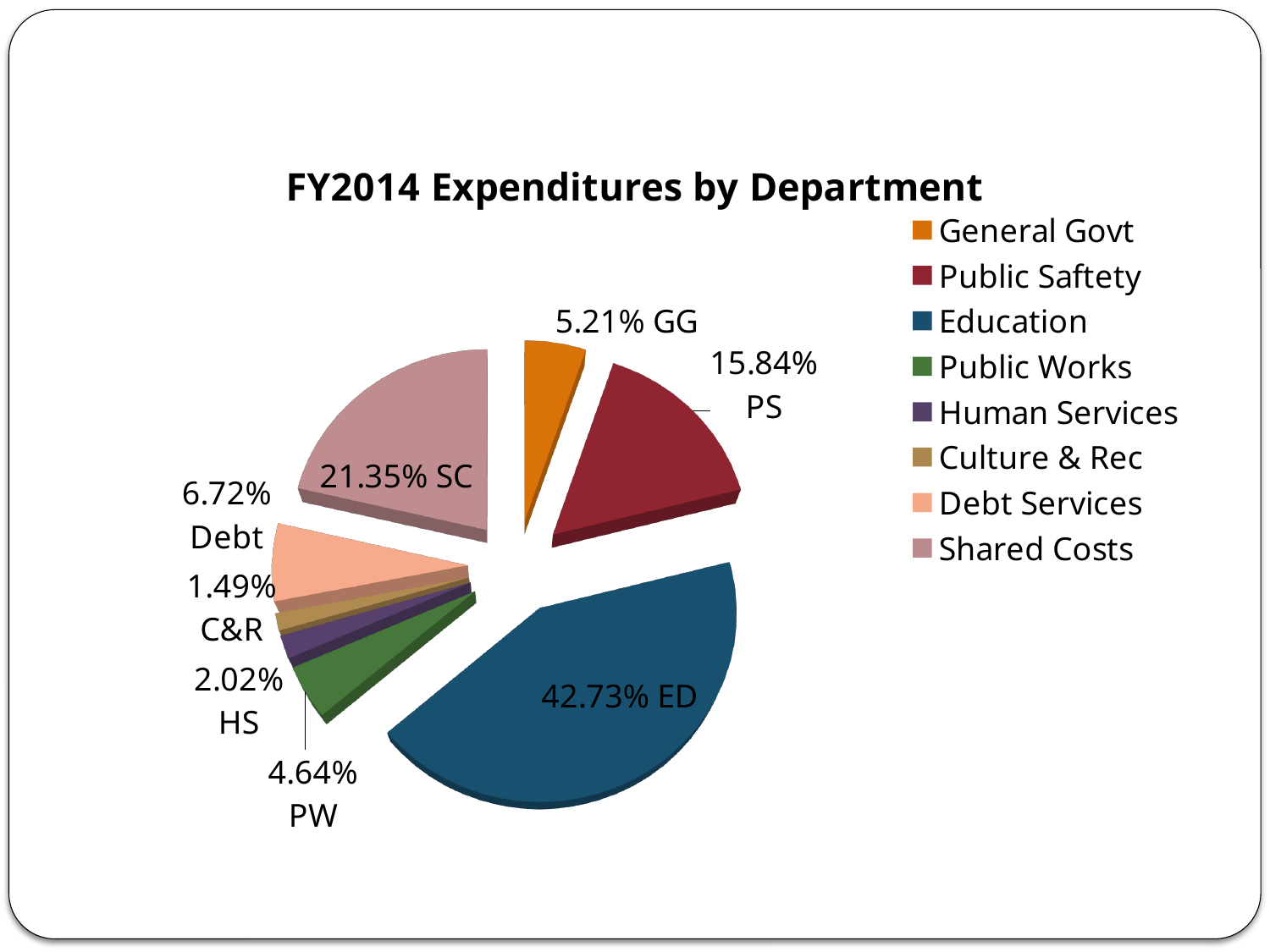
What is the difference in percentage points between the Education share and the Shared Costs share? 21.38 What share of expenditures goes to Education? 42.73% Which department has the largest share of expenditures? Education How many departments are listed in the legend? 8 Which has a larger share, Public Works or General Govt? General Govt Which department has the smallest share of expenditures? Culture & Rec What colour is the Education slice? blue What kind of chart is shown on the slide? pie chart What share of expenditures goes to Culture & Rec? 1.49% What share of expenditures goes to Shared Costs? 21.35% What share of expenditures goes to Public Safety? 15.84% What is the title of the chart? FY2014 Expenditures by Department